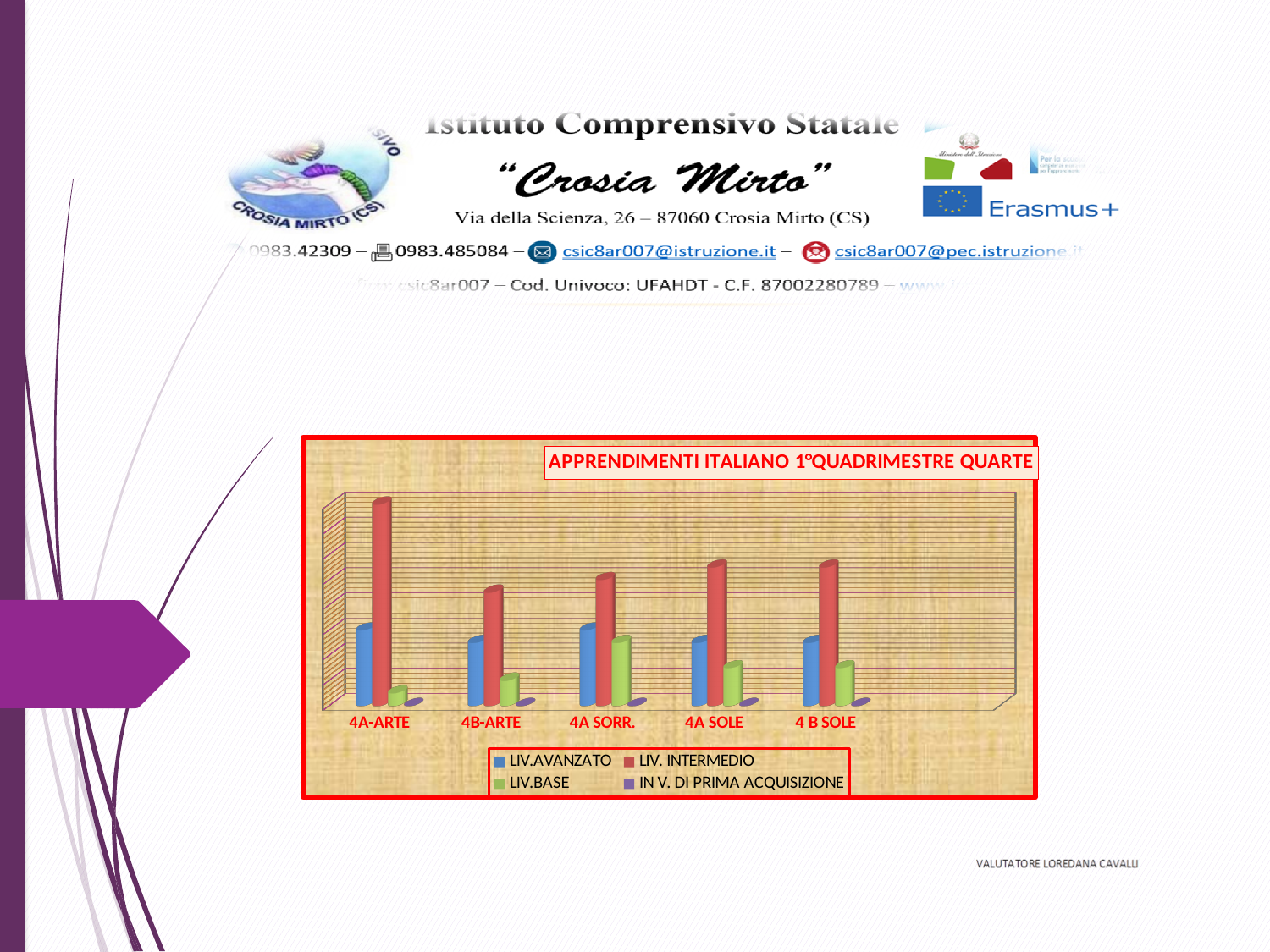
How many series does the chart legend list? 4 For 4A-ARTE, which is larger: LIV.AVANZATO or LIV. INTERMEDIO? LIV. INTERMEDIO Which series has the tallest bar in every class? LIV. INTERMEDIO Which series has the smallest bar in every class? IN V. DI PRIMA ACQUISIZIONE Which is larger: the LIV.BASE bar for 4A SORR. or the LIV.BASE bar for 4B-ARTE? 4A SORR. Which class has the highest LIV. INTERMEDIO bar? 4A-ARTE How many classes (categories) are shown on the x axis of the chart? 5 What is the title of the chart? APPRENDIMENTI ITALIANO 1°QUADRIMESTRE QUARTE Which class has the lowest LIV. INTERMEDIO bar? 4B-ARTE Which class has the highest LIV.BASE bar? 4A SORR. What kind of chart is shown on the slide? Bar chart Which class has the lowest LIV.BASE bar? 4A-ARTE